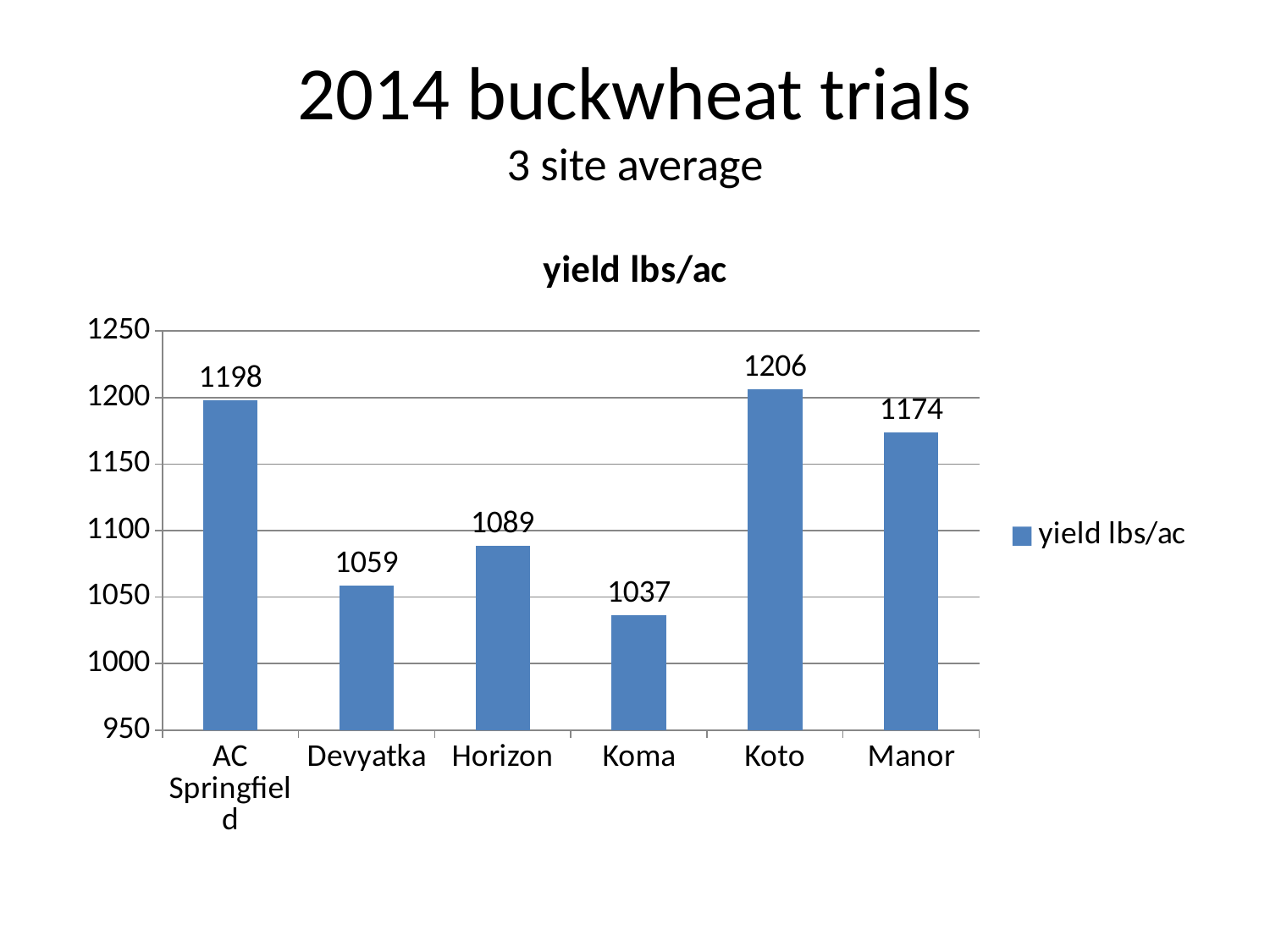
What kind of chart is shown on the slide? bar chart What is the yield for AC Springfield? 1198 How many varieties are shown on the chart? 6 Which variety has the lowest yield? Koma Which has a higher yield, Manor or Horizon? Manor What is the title of the chart? yield lbs/ac What is the yield for Devyatka? 1059 Which variety has the highest yield? Koto What is the difference in yield between Horizon and Devyatka? 30 What is the yield for Koto? 1206 What is the difference in yield between Koto and Koma? 169 Is the yield for Koma greater or less than 1050? less